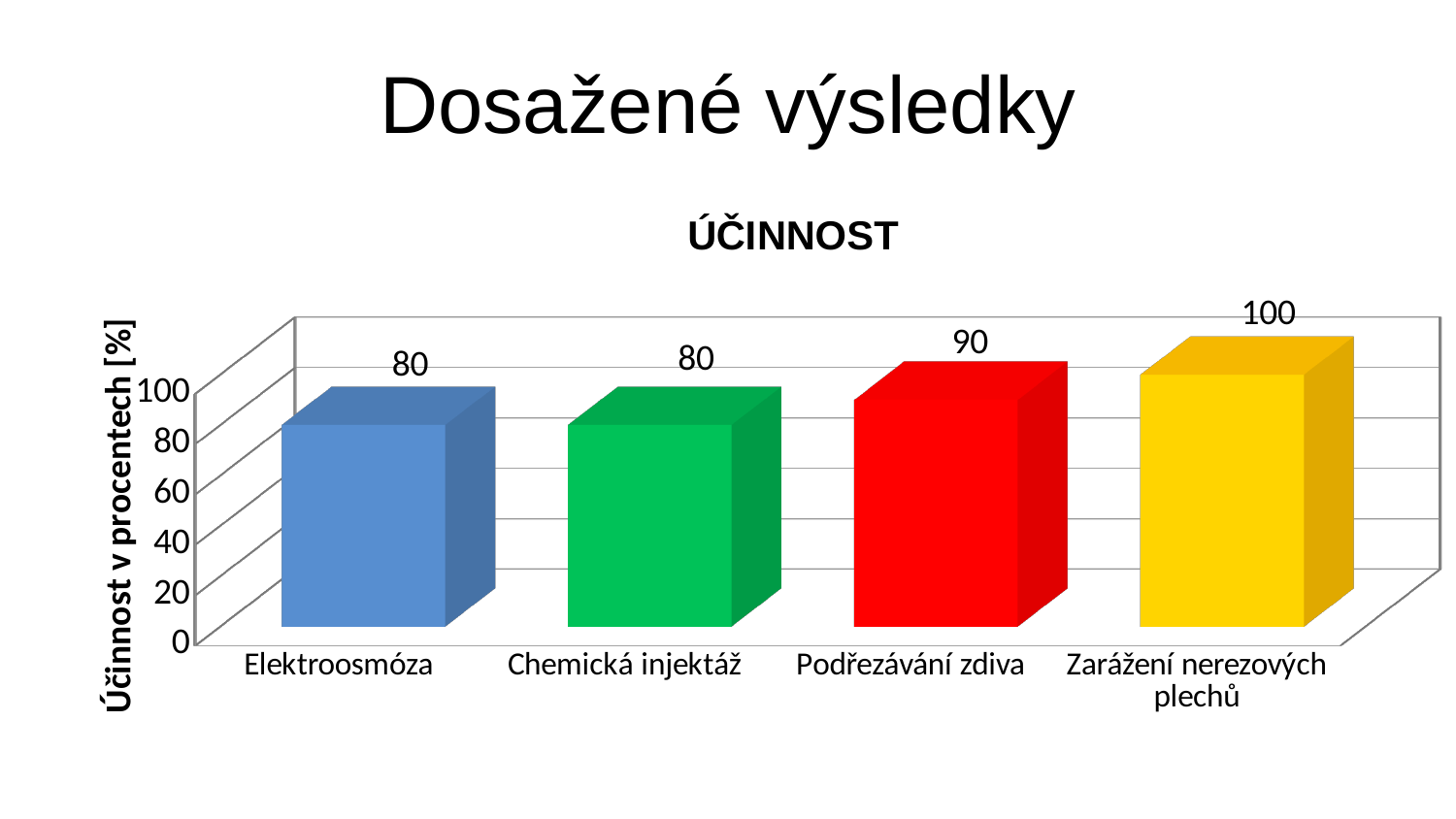
How many categories are shown in the chart? 4 What is the difference between the values for Podřezávání zdiva and Chemická injektáž? 10 What is the value for Chemická injektáž? 80 Do the values rise or fall from left to right along the x axis? rise What is the value for Podřezávání zdiva? 90 Which category has the highest value? Zarážení nerezových plechů What is the difference between the values for Zarážení nerezových plechů and Elektroosmóza? 20 Which is larger, the value for Podřezávání zdiva or the value for Elektroosmóza? Podřezávání zdiva What is the title of the chart? ÚČINNOST What is the value for Elektroosmóza? 80 What kind of chart is shown? bar chart What is the value for Zarážení nerezových plechů? 100